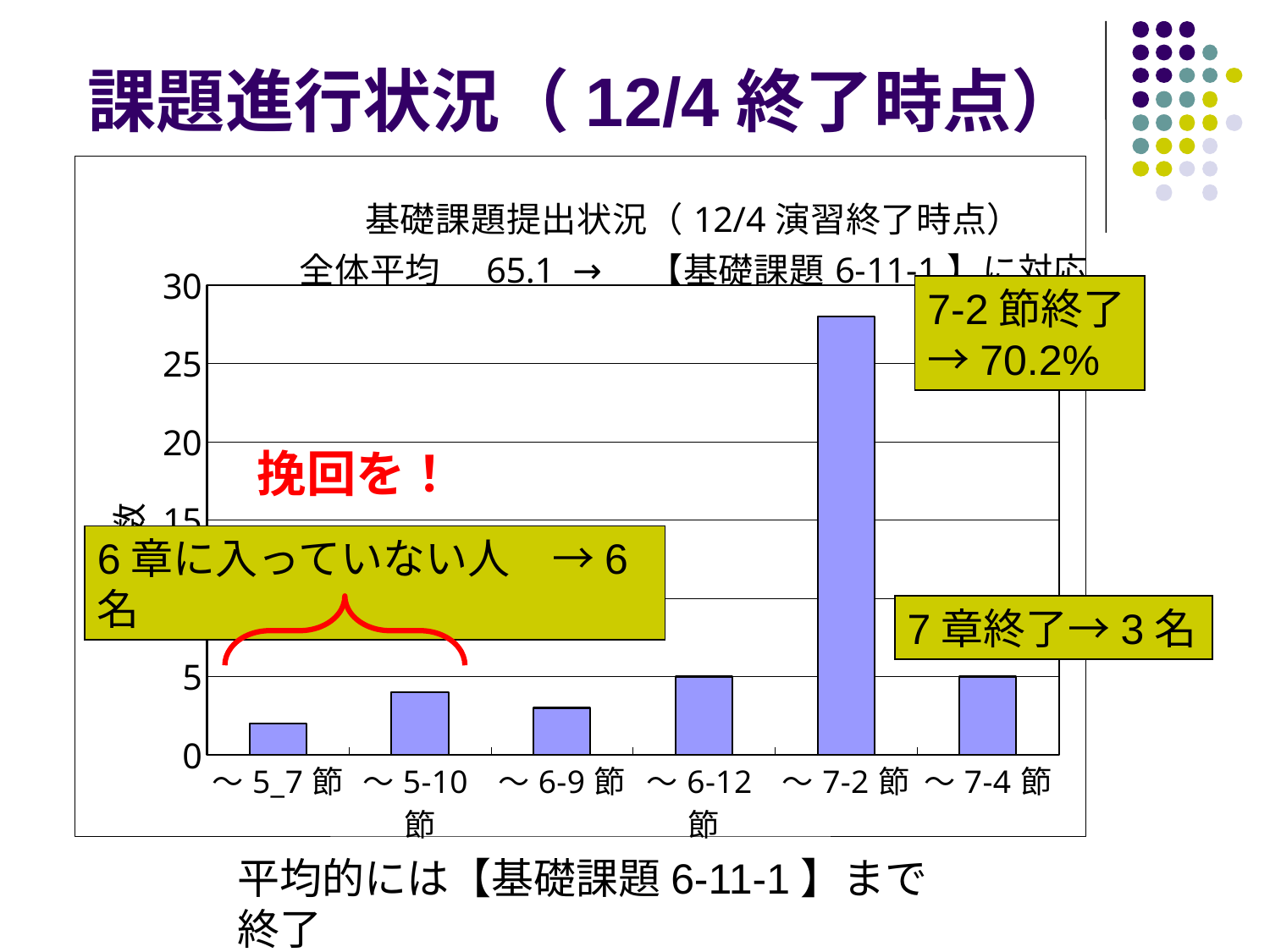
What kind of chart is shown on the slide? bar chart Which is larger, the value for ～5-10節 or the value for ～5_7節? ～5-10節 Is the value for ～7-2節 greater or less than 25? greater Which category has the lowest bar in the chart? ～5_7節 How many categories are plotted along the x axis of the chart? 6 What is the value for ～7-4節? 5 Is the value for ～5_7節 greater or less than 5? less Is the value for ～6-9節 greater or less than 5? less Which category has the highest bar in the chart? ～7-2節 What is the title of the chart? 基礎課題提出状況（12/4演習終了時点） 全体平均 65.1 → 【基礎課題6-11-1】に対応 Which is larger, the value for ～7-2節 or the value for ～6-12節? ～7-2節